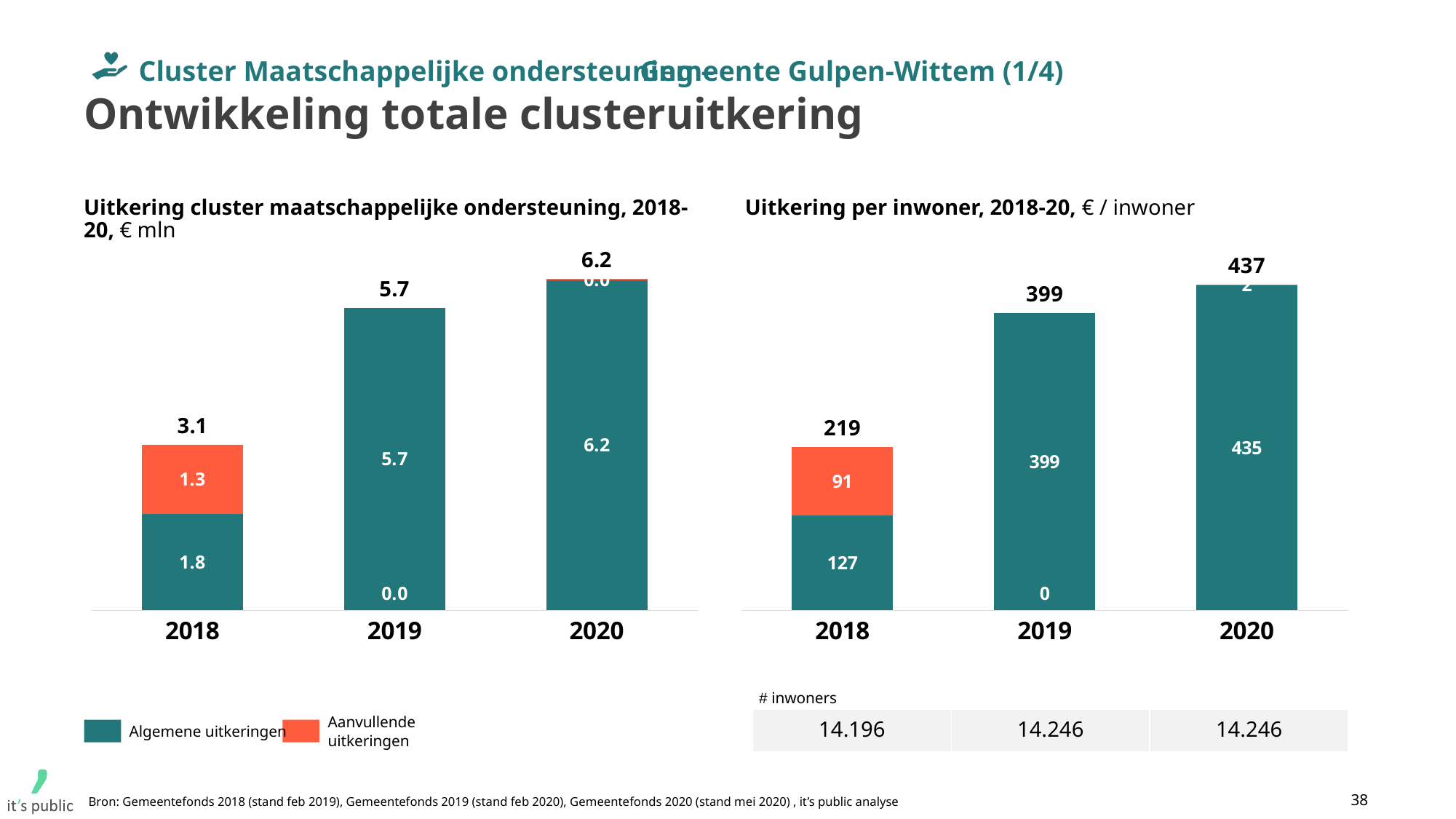
In the left chart (Uitkering cluster maatschappelijke ondersteuning), what is the value of Aanvullende uitkeringen in 2018? 1.3 How many series does the legend list for the left chart? 2 In the right chart (Uitkering per inwoner), which year has the lowest total? 2018 In the left chart (Uitkering cluster maatschappelijke ondersteuning), what is the difference between the 2020 total and the 2018 total? 3.1 In the left chart (Uitkering cluster maatschappelijke ondersteuning), which year has the highest total? 2020 In the right chart (Uitkering per inwoner), what is the difference between the 2020 total and the 2019 total? 38 In the right chart (Uitkering per inwoner), what is the value of Aanvullende uitkeringen in 2018? 91 In the left chart (Uitkering cluster maatschappelijke ondersteuning), what is the value of Algemene uitkeringen in 2019? 5.7 In the left chart (Uitkering cluster maatschappelijke ondersteuning), what is the total value of the 2018 bar? 3.1 In the right chart (Uitkering per inwoner), what is the value of Algemene uitkeringen in 2020? 435 In the right chart (Uitkering per inwoner), what is the total value of the 2018 bar? 219 What kind of chart is the right chart (Uitkering per inwoner)? Stacked bar chart